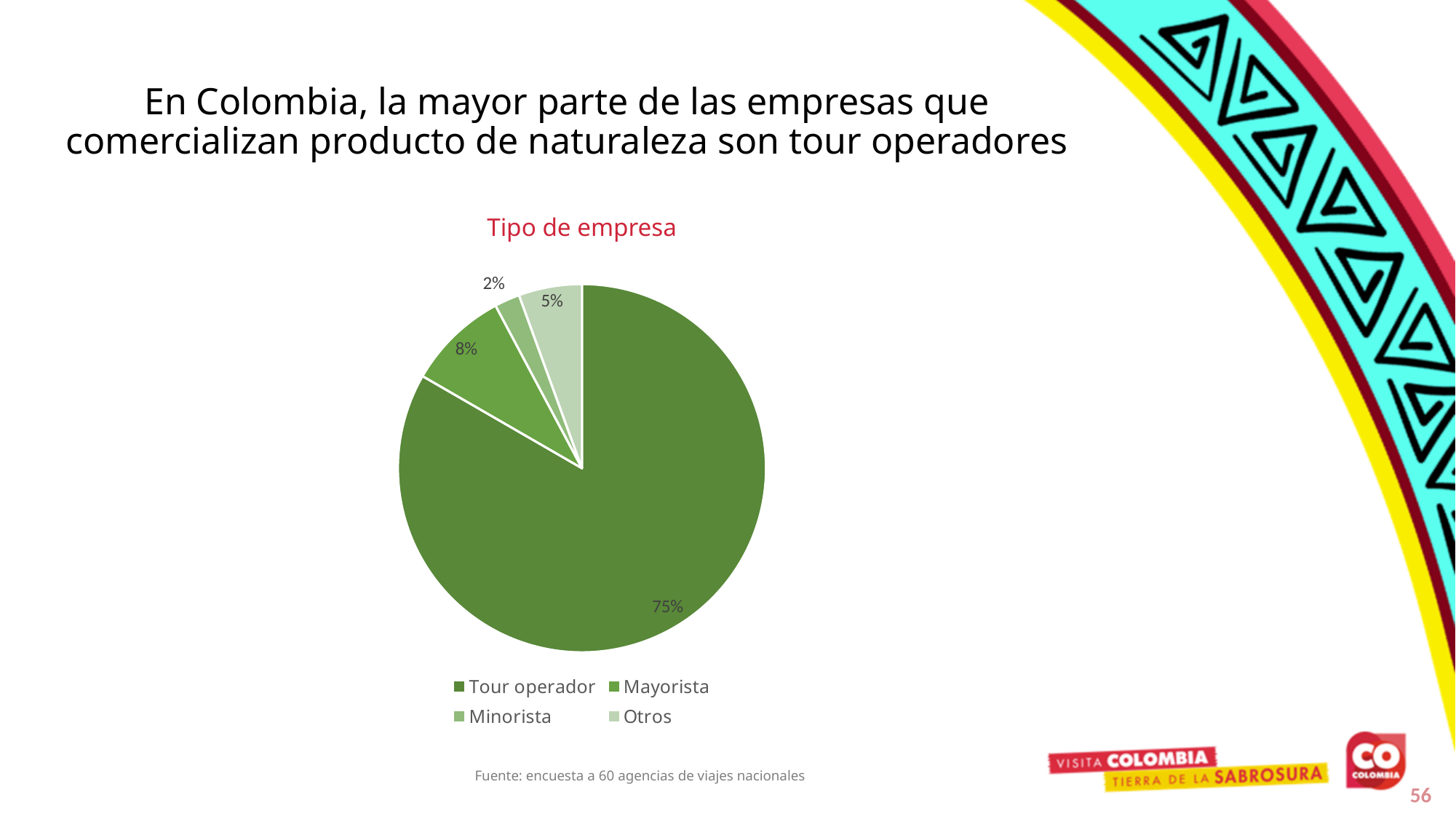
What is the title of the pie chart? Tipo de empresa Which category has the smallest share of the pie chart? Minorista What percentage of the pie chart is Otros? 5% According to the source note, how many agencies were surveyed? 60 What percentage of the pie chart is Tour operador? 75% How many categories does the pie chart show? 4 What percentage of the pie chart is Minorista? 2% Which is larger, the share for Otros or the share for Mayorista? Mayorista What is the difference in percentage points between Tour operador and Mayorista? 67 What percentage of the pie chart is Mayorista? 8% Which category has the largest share of the pie chart? Tour operador What type of chart is shown under the title "Tipo de empresa"? Pie chart